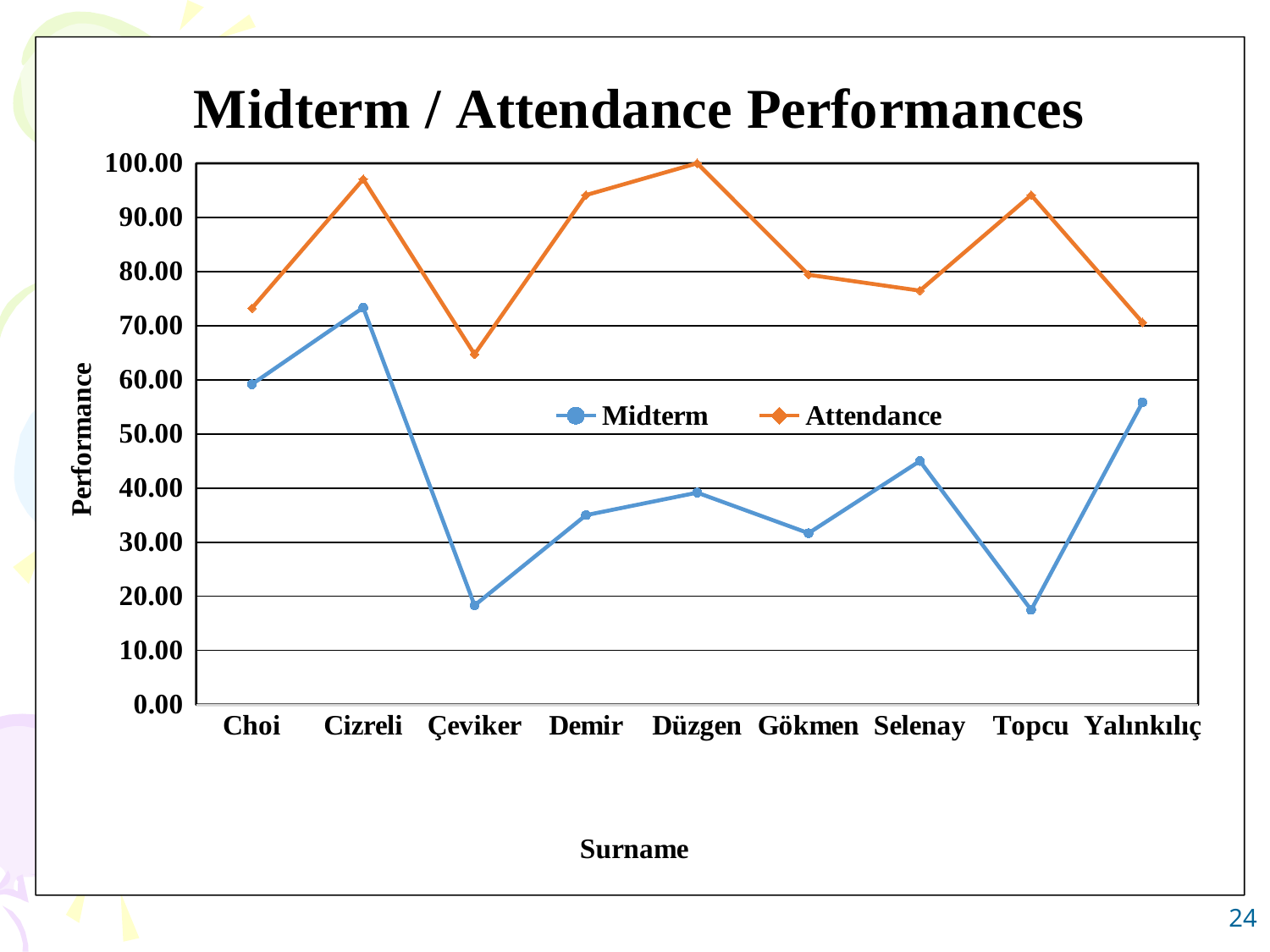
Is the Attendance value for Cizreli greater or less than 90.00? greater Which surname has the highest Midterm value? Cizreli Which surname has the highest Attendance value? Düzgen What is the title of the chart? Midterm / Attendance Performances How many series does the legend list? 2 What is the Attendance value for Düzgen? 100.00 What kind of chart is shown on the slide? line chart How many surnames are plotted along the x axis? 9 Which is larger, the Midterm value for Cizreli or the Midterm value for Selenay? Cizreli Is the Midterm value for Selenay greater or less than 40.00? greater Which surname has the lowest Attendance value? Çeviker